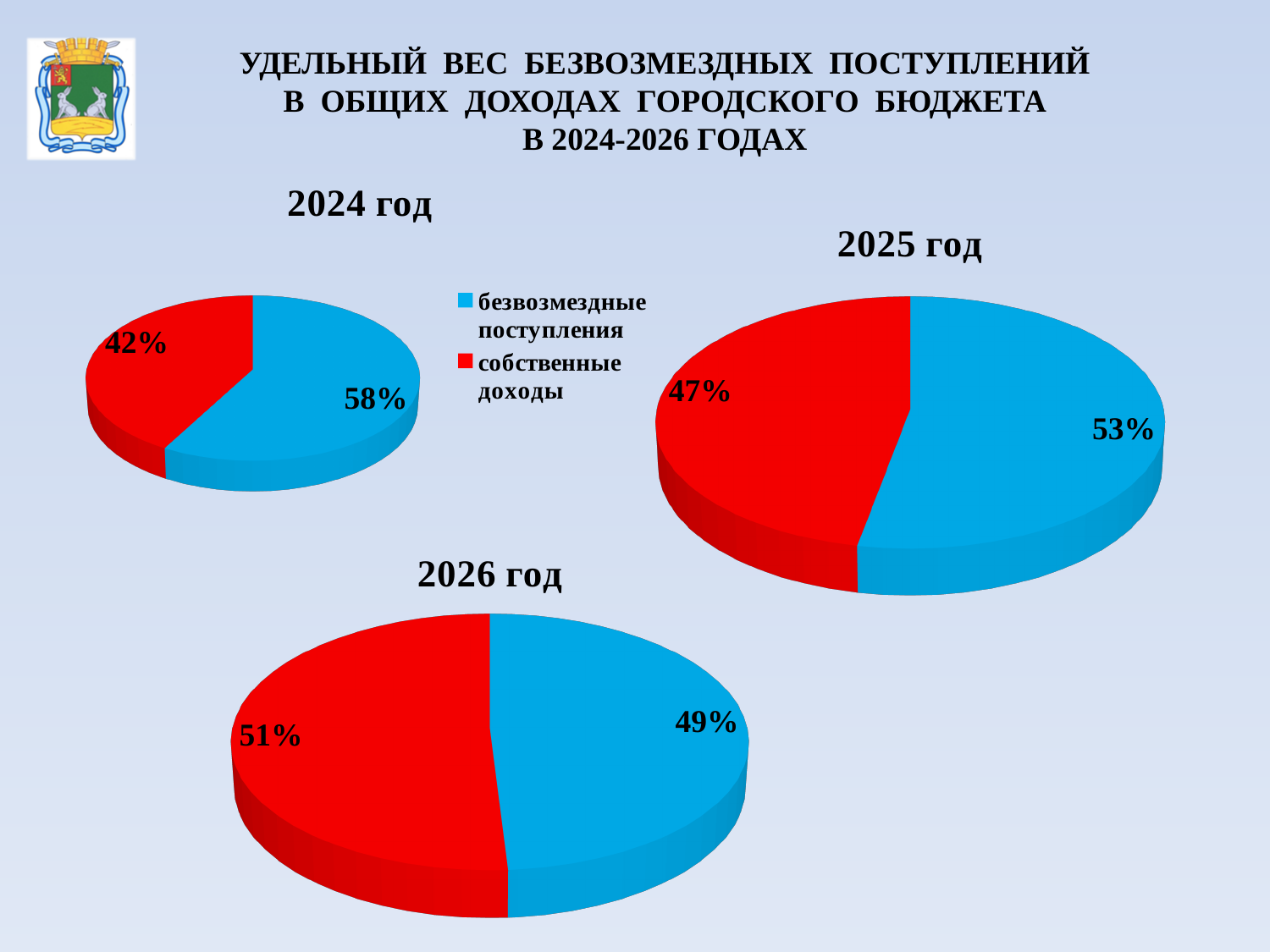
Which colour represents безвозмездные поступления in the legend? Blue In the 2024 год pie chart, which slice is larger: безвозмездные поступления or собственные доходы? безвозмездные поступления In the 2026 год pie chart, what share is собственные доходы? 51% In the 2026 год pie chart, what share is безвозмездные поступления? 49% In the 2026 год pie chart, which slice is the largest? собственные доходы In the 2025 год pie chart, what share is собственные доходы? 47% What kind of chart is used for each year on this slide? Pie chart In the 2024 год pie chart, what share is безвозмездные поступления? 58% How many series does the legend list? 2 In the 2025 год pie chart, what share is безвозмездные поступления? 53% In the 2024 год pie chart, what is the difference between the безвозмездные поступления share and the собственные доходы share? 16% In the 2024 год pie chart, what share is собственные доходы? 42%